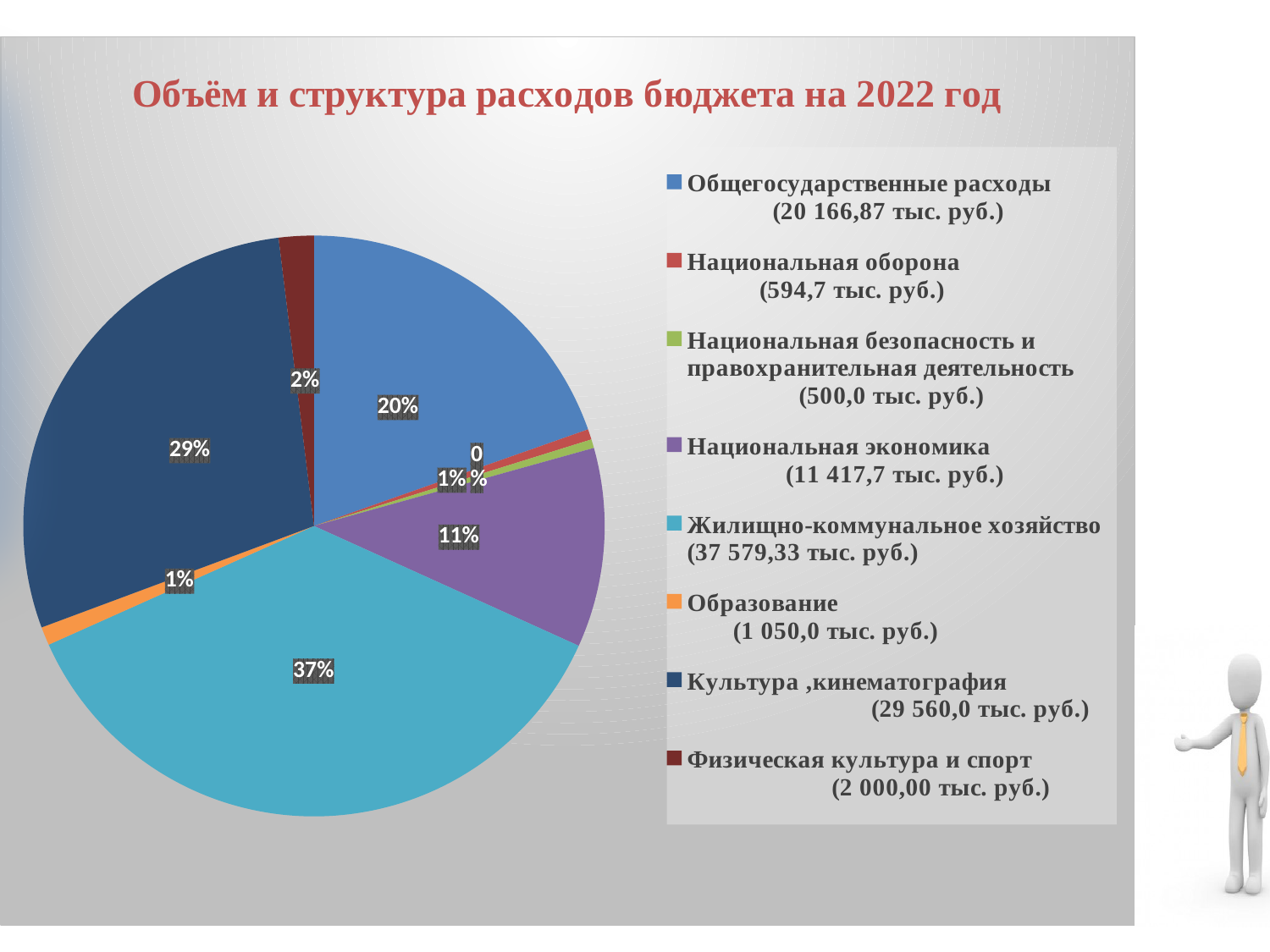
How many categories does the pie chart show? 8 Which category has the largest share of the pie? Жилищно-коммунальное хозяйство What share of the pie does Жилищно-коммунальное хозяйство have? 37% By how many percentage points does the share of Жилищно-коммунальное хозяйство exceed the share of Культура, кинематография? 8 What share of the pie does Физическая культура и спорт have? 2% What kind of chart is shown on the slide? pie chart What share of the pie does Культура, кинематография have? 29% What is the title of the chart? Объём и структура расходов бюджета на 2022 год Which is larger: the share for Культура, кинематография or the share for Общегосударственные расходы? Культура, кинематография